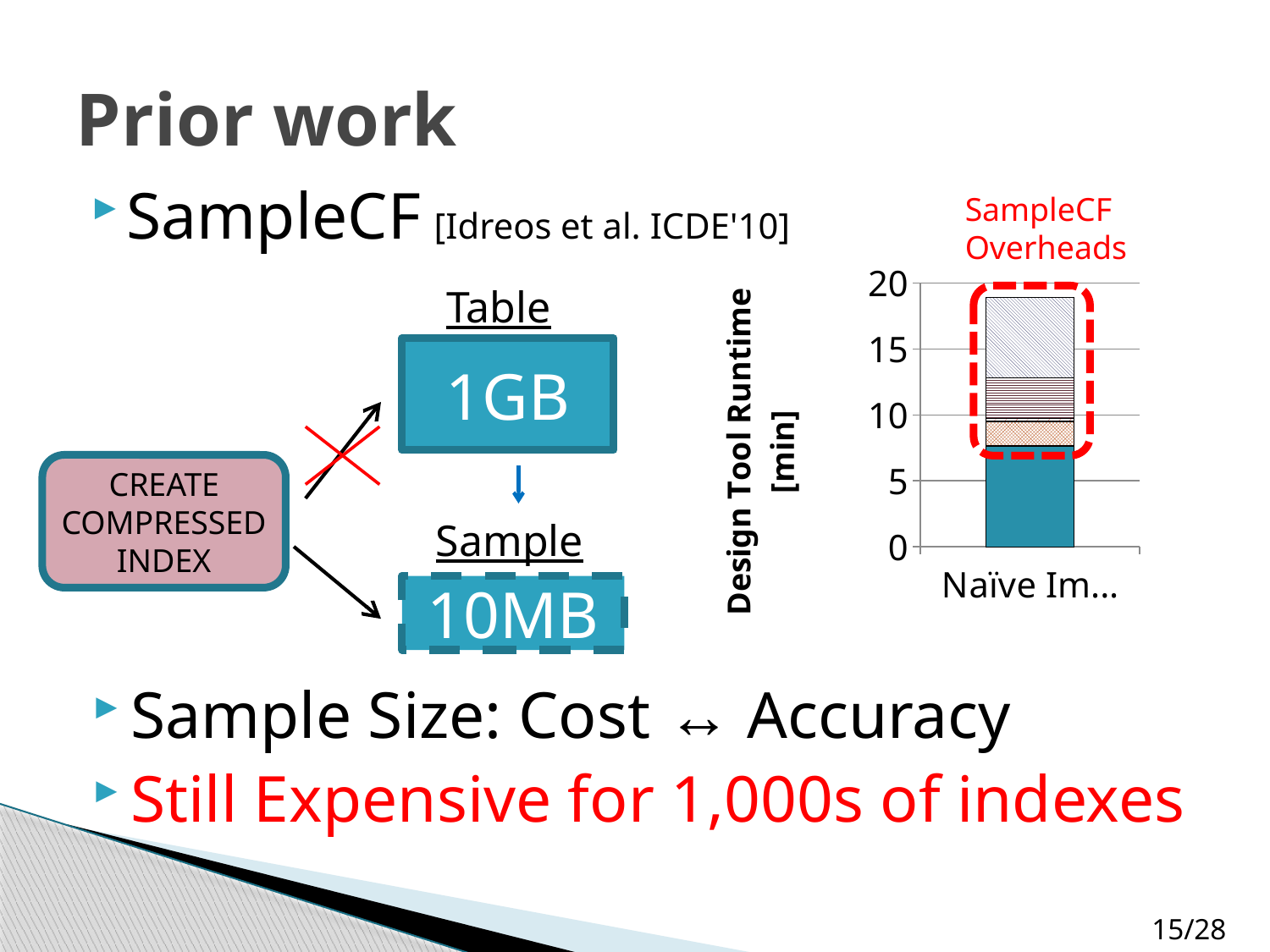
Is the solid bottom segment of the stacked bar greater or less than 10? less What is the label of the vertical axis of the chart? Design Tool Runtime [min] What is the highest tick value shown on the vertical axis of the chart? 20 Is the top of the segments enclosed by the red dashed outline greater or less than 15? greater Is the total height of the stacked bar in the chart greater or less than 15? greater What kind of chart is shown on the right side of the slide? bar chart How many bars does the chart on the right of the slide show? 1